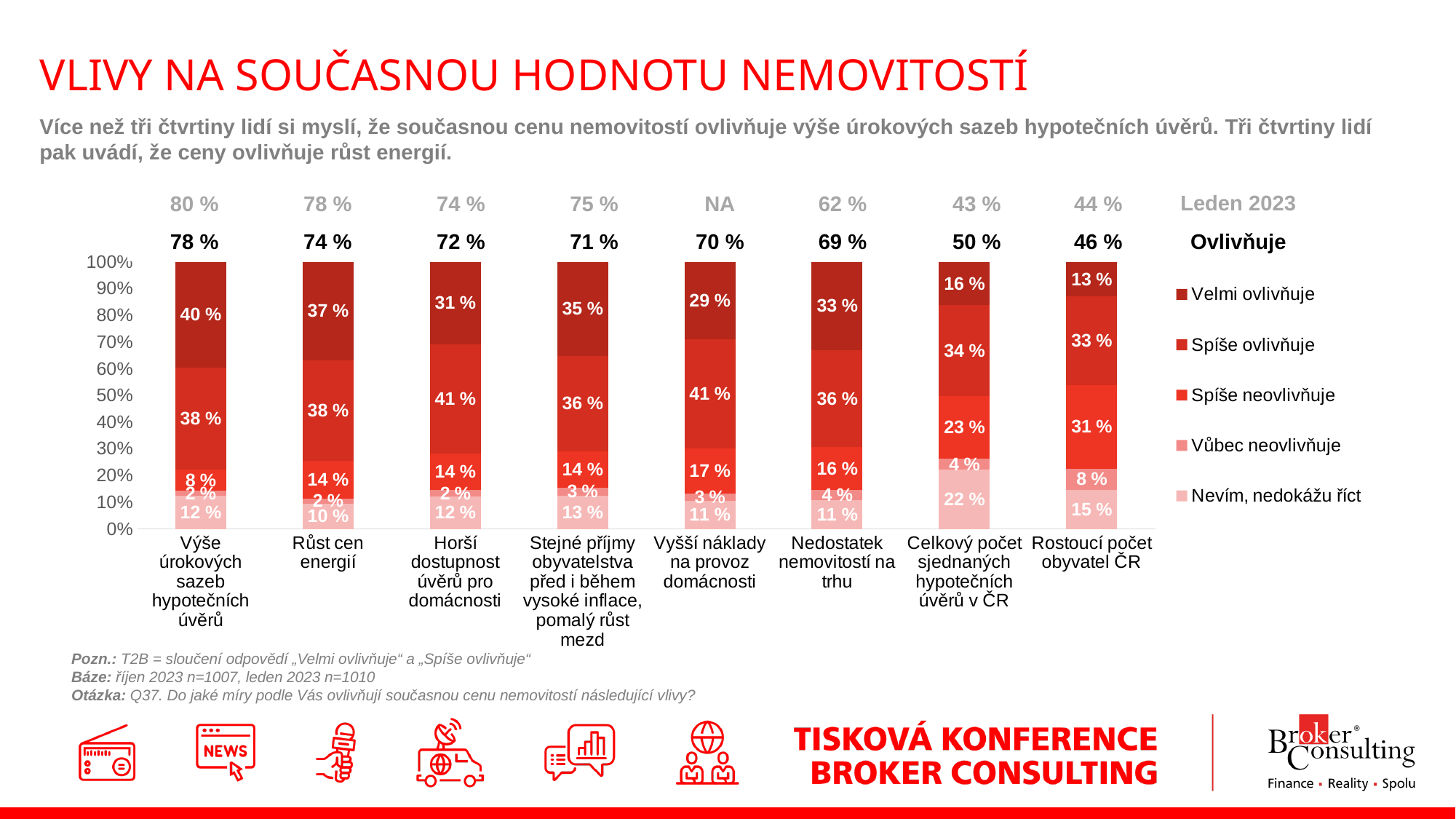
How many categories (influences) are shown on the x axis of the chart? 8 Which has the larger "Spíše ovlivňuje" share: "Horší dostupnost úvěrů pro domácnosti" or "Růst cen energií"? Horší dostupnost úvěrů pro domácnosti How many series does the chart legend list? 5 Which category has the highest "Velmi ovlivňuje" share? Výše úrokových sazeb hypotečních úvěrů Which category has the lowest "Velmi ovlivňuje" share? Rostoucí počet obyvatel ČR What percentage of respondents answered "Velmi ovlivňuje" for "Výše úrokových sazeb hypotečních úvěrů"? 40 % For which category is the "Leden 2023" value shown as NA? Vyšší náklady na provoz domácnosti What type of chart is shown on the slide? Stacked bar chart What is the "Nevím, nedokážu říct" share for "Celkový počet sjednaných hypotečních úvěrů v ČR"? 22 % How much larger is the "Spíše neovlivňuje" share for "Rostoucí počet obyvatel ČR" than for "Výše úrokových sazeb hypotečních úvěrů"? 23 % What is the combined "Ovlivňuje" (T2B) value shown above the bar for "Nedostatek nemovitostí na trhu"? 69 % What is the "Leden 2023" value shown for "Růst cen energií"? 78 %